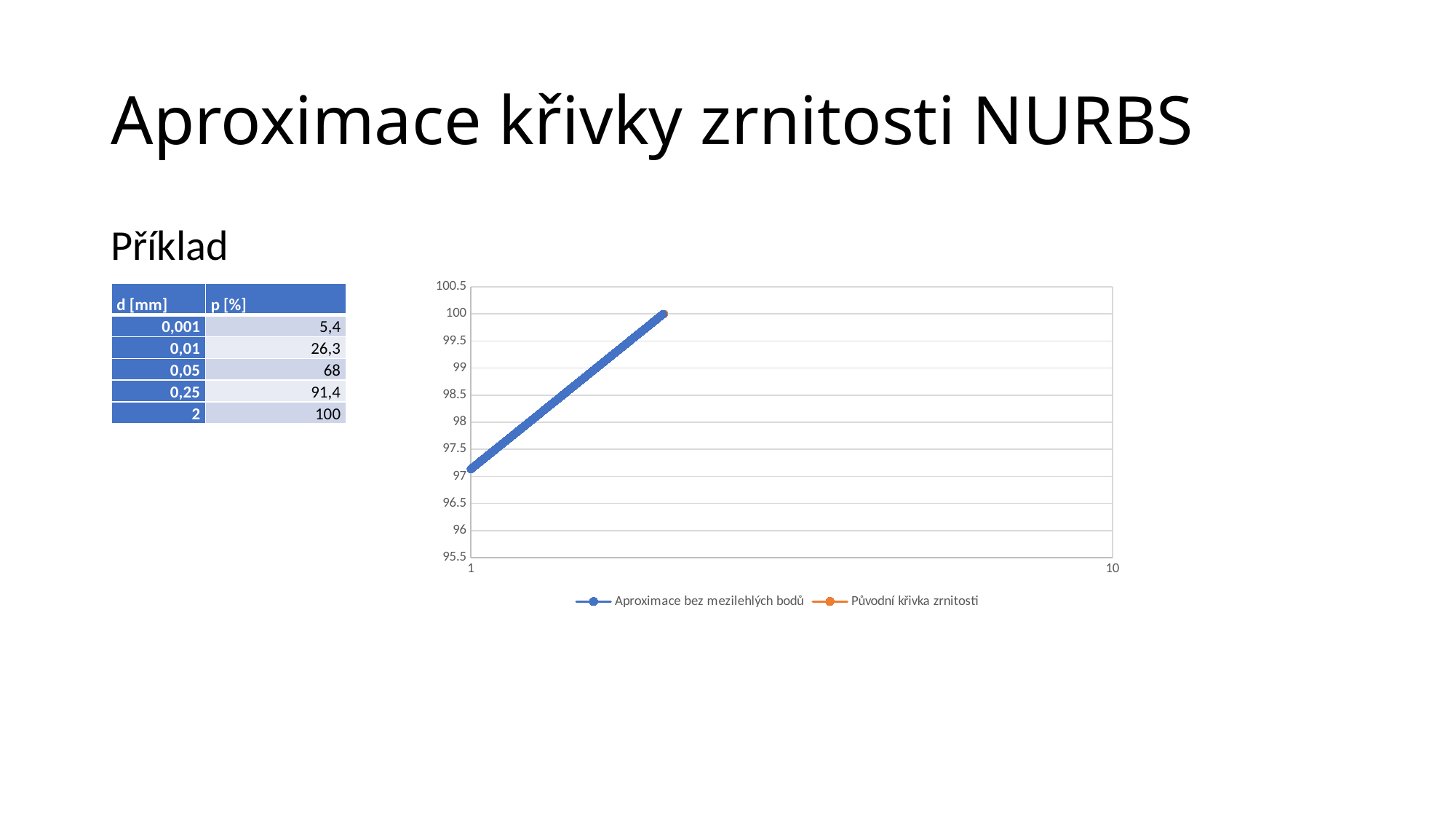
Is the value of the "Aproximace bez mezilehlých bodů" series at x = 1 greater or less than 97.5? less Which colour is used for the series "Aproximace bez mezilehlých bodů"? blue Is the value of the "Aproximace bez mezilehlých bodů" series at x = 1 greater or less than 96.5? greater What kind of chart is shown on the slide? line chart Is the highest plotted value of the "Aproximace bez mezilehlých bodů" series greater or less than 99.5? greater Do the plotted values rise or fall as the x axis increases? rise What are the two series named in the chart legend? Aproximace bez mezilehlých bodů; Původní křivka zrnitosti How many series does the chart legend list? 2